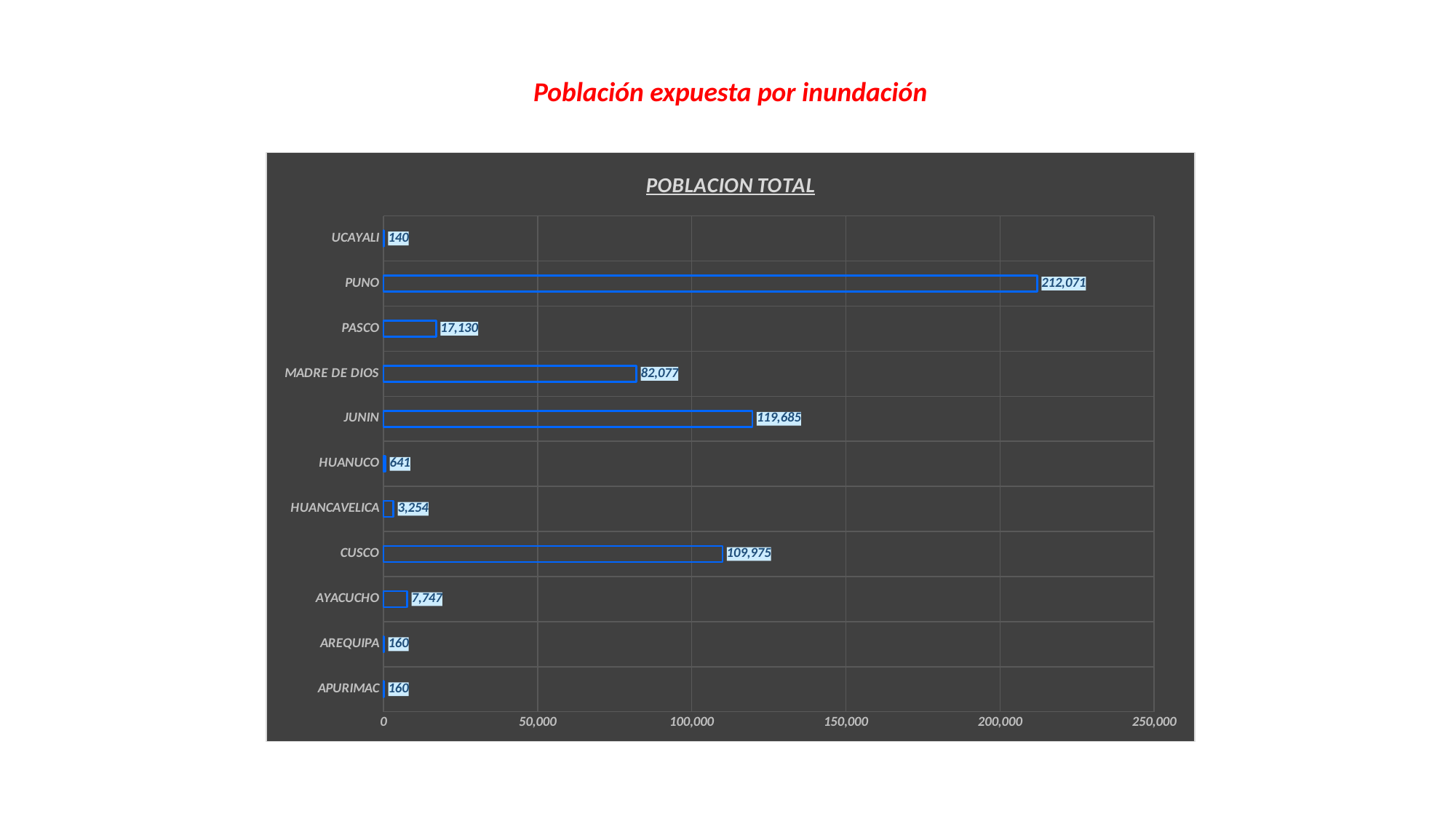
What is the difference between the values for JUNIN and CUSCO? 9,710 Which category has the lowest value? UCAYALI How many categories are shown in the chart? 11 Is the value for CUSCO greater or less than 100,000? greater What is the value for MADRE DE DIOS? 82,077 What is the difference between the values for PUNO and JUNIN? 92,386 Which is larger, the value for PASCO or the value for AYACUCHO? PASCO What kind of chart is shown? bar chart What is the value for PUNO? 212,071 What is the title of the chart? POBLACION TOTAL Which category has the highest value? PUNO What is the value for HUANCAVELICA? 3,254